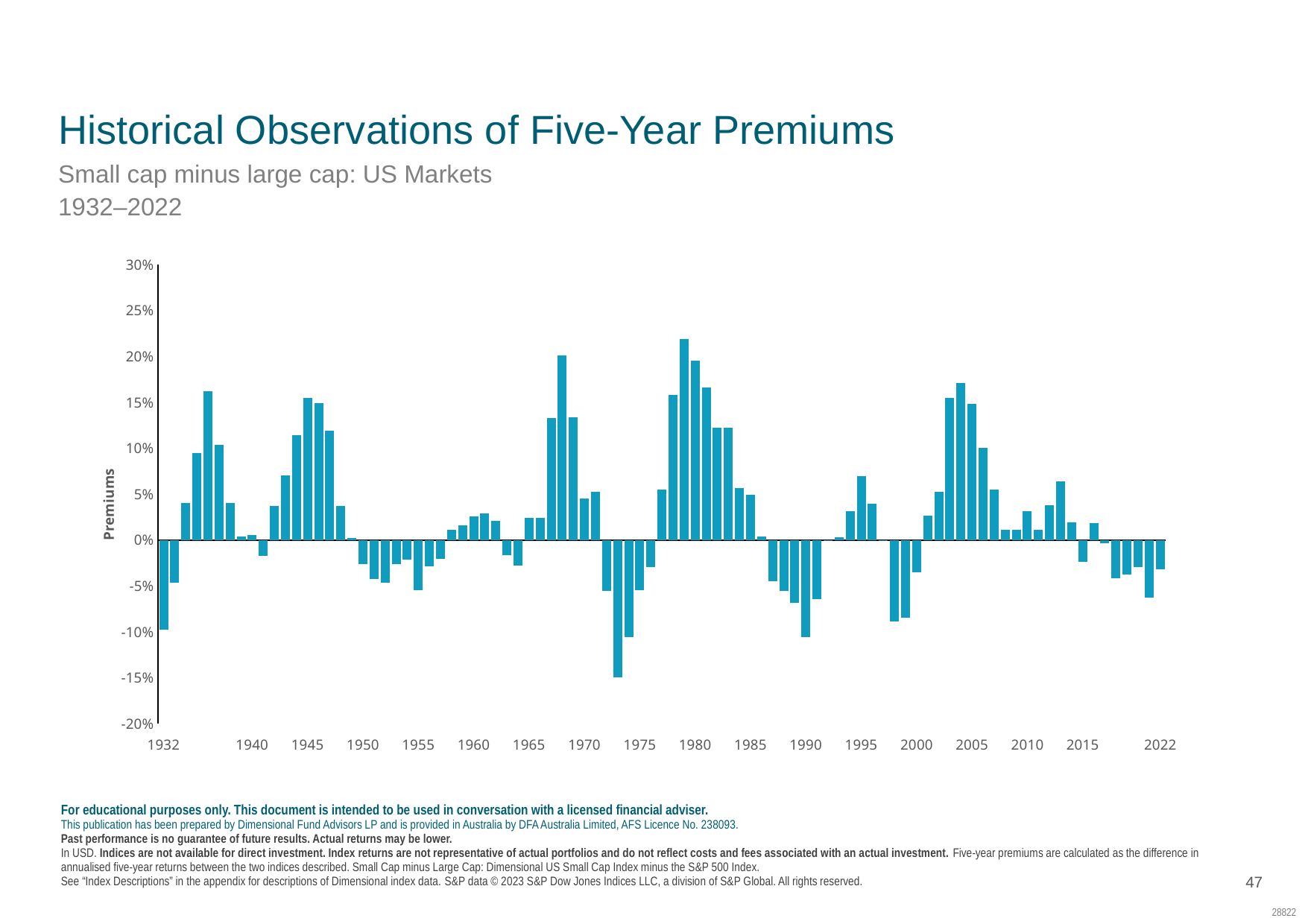
Is the five-year premium for 1932 greater or less than -5%? less Which year has the larger five-year premium, 1980 or 2000? 1980 Is the five-year premium for 1980 greater or less than 15%? greater Is the five-year premium for 1990 greater or less than -5%? less Do the five-year premiums rise or fall from 2005 to 2010? fall What kind of chart is shown on the slide? Bar chart Which year has the larger five-year premium, 1945 or 1950? 1945 What is the label on the vertical axis of the chart? Premiums